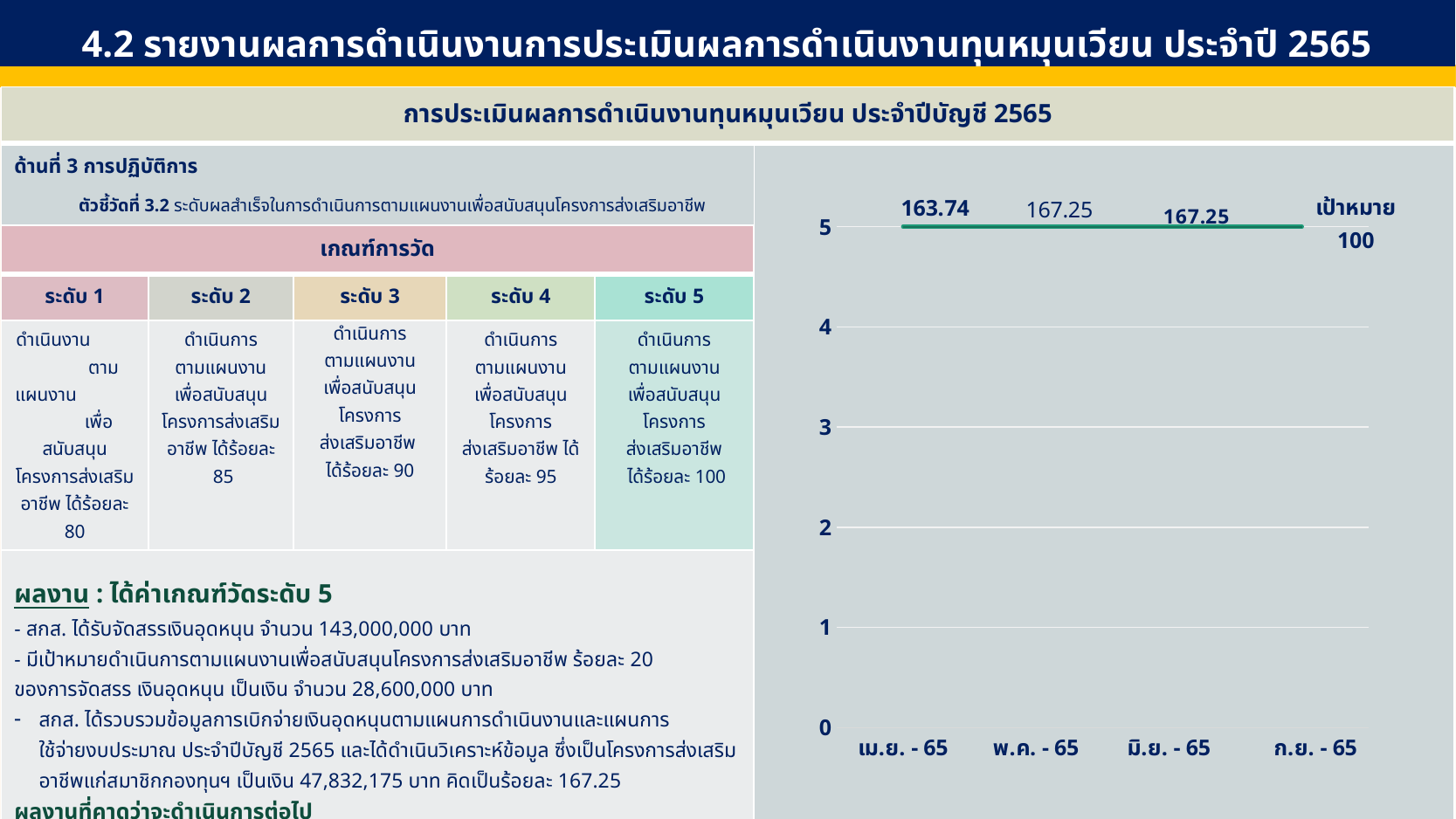
Which has the larger labelled value, เม.ย. - 65 or พ.ค. - 65? พ.ค. - 65 What target value (เป้าหมาย) is shown next to the chart? 100 What kind of chart is shown on the right of the slide? Line chart Which month has the lowest labelled value on the chart? เม.ย. - 65 Does the labelled value rise or fall from เม.ย. - 65 to พ.ค. - 65? Rises What value is labelled for เม.ย. - 65 on the chart? 163.74 What value is labelled for พ.ค. - 65 on the chart? 167.25 What is the difference between the labelled values for พ.ค. - 65 and เม.ย. - 65? 3.51 What is the first category on the x axis of the chart? เม.ย. - 65 How many categories are shown on the x axis of the chart? 4 What is the highest tick value on the y axis of the chart? 5 What value is labelled for มิ.ย. - 65 on the chart? 167.25